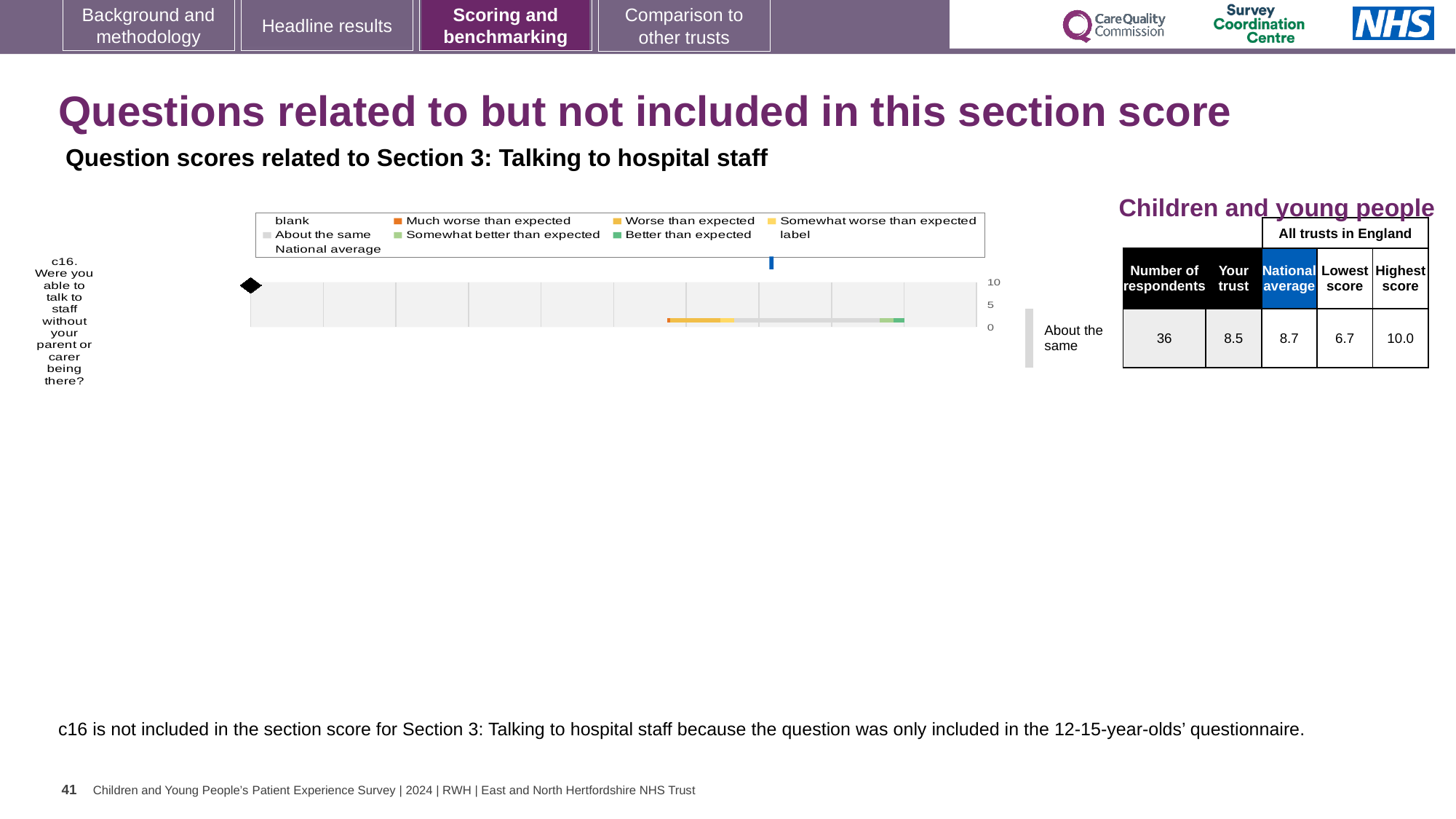
How many respondents answered question c16? 36 Which is higher for question c16, the trust's score or the national average? National average How many survey questions are plotted in the chart? 1 What is the maximum value shown on the chart's score axis? 10 What is the difference between the highest and lowest scores for question c16? 3.3 What is the lowest score among all trusts in England for question c16? 6.7 Which question number is plotted in the chart? c16 What is the national average score for question c16? 8.7 What is the highest score among all trusts in England for question c16? 10.0 What is the 'Your trust' score for question c16? 8.5 What kind of chart is shown on the slide? bar chart Which benchmark category is the trust's result for c16 placed in? About the same